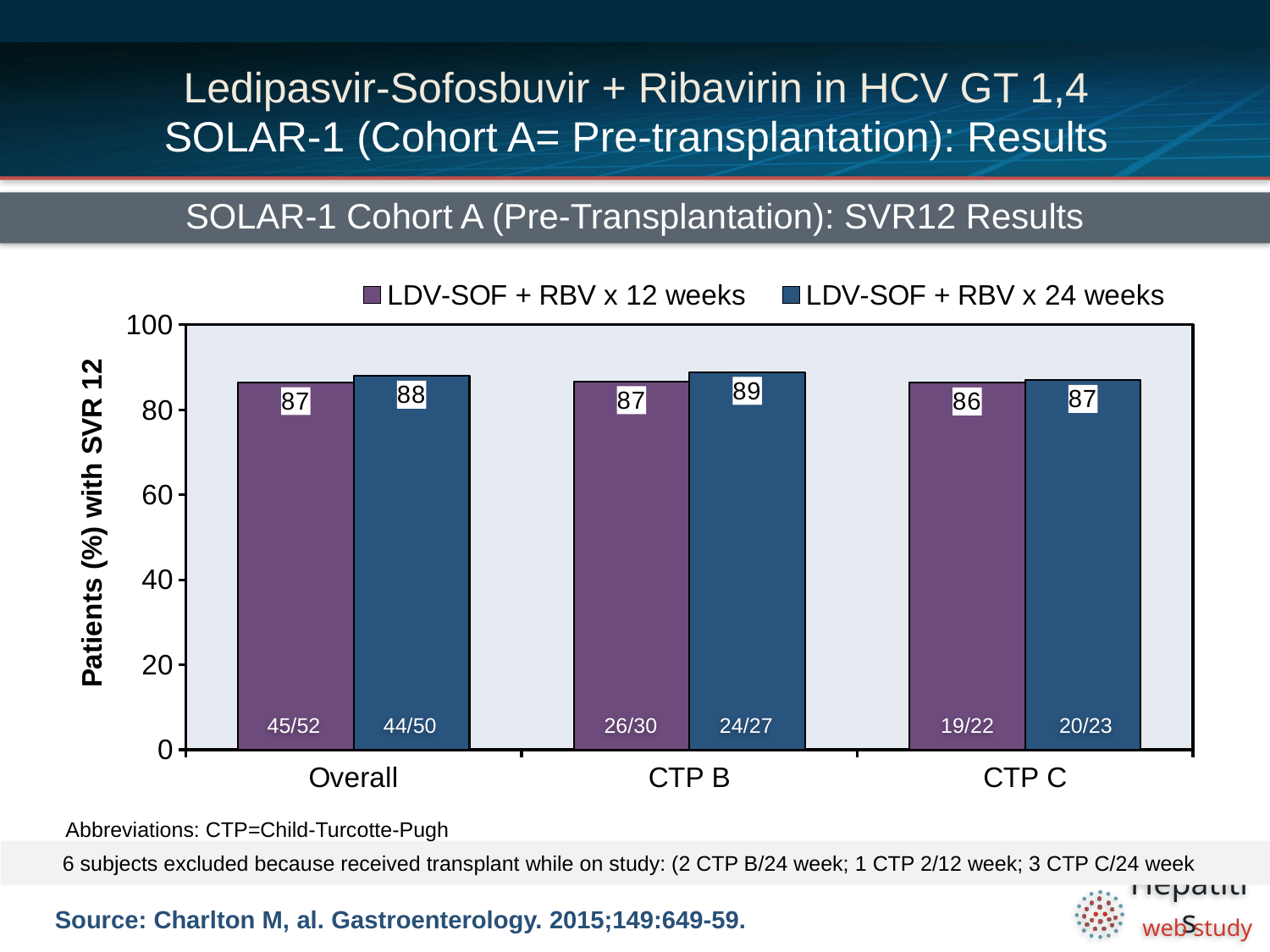
What fraction of patients is shown inside the LDV-SOF + RBV x 12 weeks bar for CTP C? 19/22 How many categories are shown on the x axis? 3 How many series does the legend list? 2 Which category has the highest value for the LDV-SOF + RBV x 24 weeks series? CTP B Which category has the lowest value for the LDV-SOF + RBV x 12 weeks series? CTP C What fraction of patients is shown inside the LDV-SOF + RBV x 24 weeks bar for the Overall category? 44/50 What is the SVR12 rate for the LDV-SOF + RBV x 12 weeks series in the CTP C category? 86 What is the SVR12 rate for the LDV-SOF + RBV x 24 weeks series in the CTP B category? 89 What is the difference between the 24-week and 12-week SVR12 rates in the CTP B category? 2 What is the label of the y axis? Patients (%) with SVR 12 What is the SVR12 rate for the LDV-SOF + RBV x 12 weeks series in the Overall category? 87 What kind of chart is shown on the slide? Bar chart